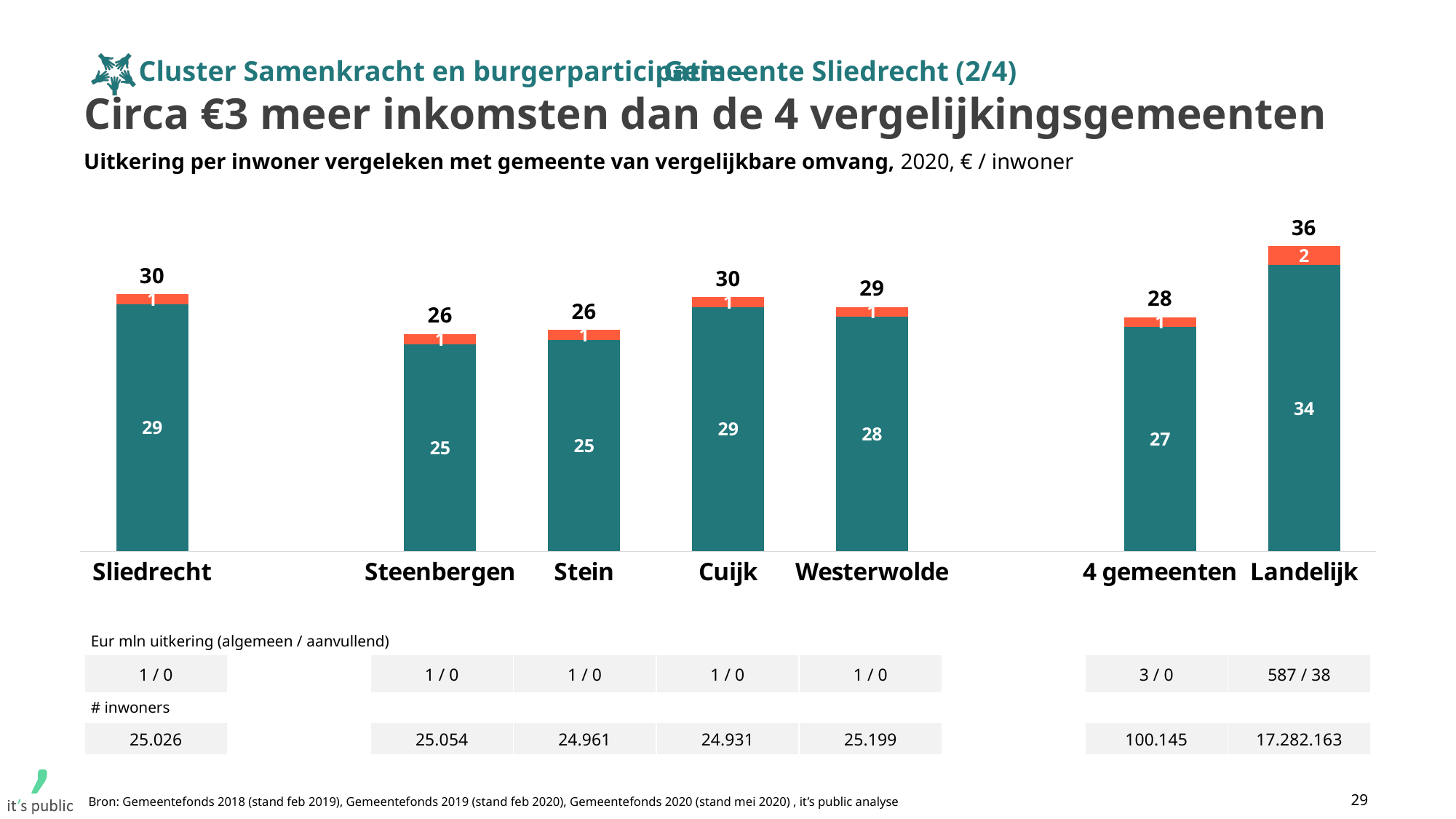
What is the value of the teal (lower) segment for Cuijk? 29 In what unit are the chart values expressed, according to the chart subtitle? € / inwoner Which has a larger total, Sliedrecht or Westerwolde? Sliedrecht What is the value of the orange (upper) segment for Landelijk? 2 Which categories share the lowest total value? Steenbergen and Stein What is the value of the teal (lower) segment for 4 gemeenten? 27 How many categories are shown on the x axis? 7 What is the difference between the total for Landelijk and the total for 4 gemeenten? 8 What is the total value shown above the bar for Sliedrecht? 30 Which category has the highest total value? Landelijk What is the difference between the total for Sliedrecht and the total for 4 gemeenten? 2 What kind of chart is shown on the slide? Stacked bar chart